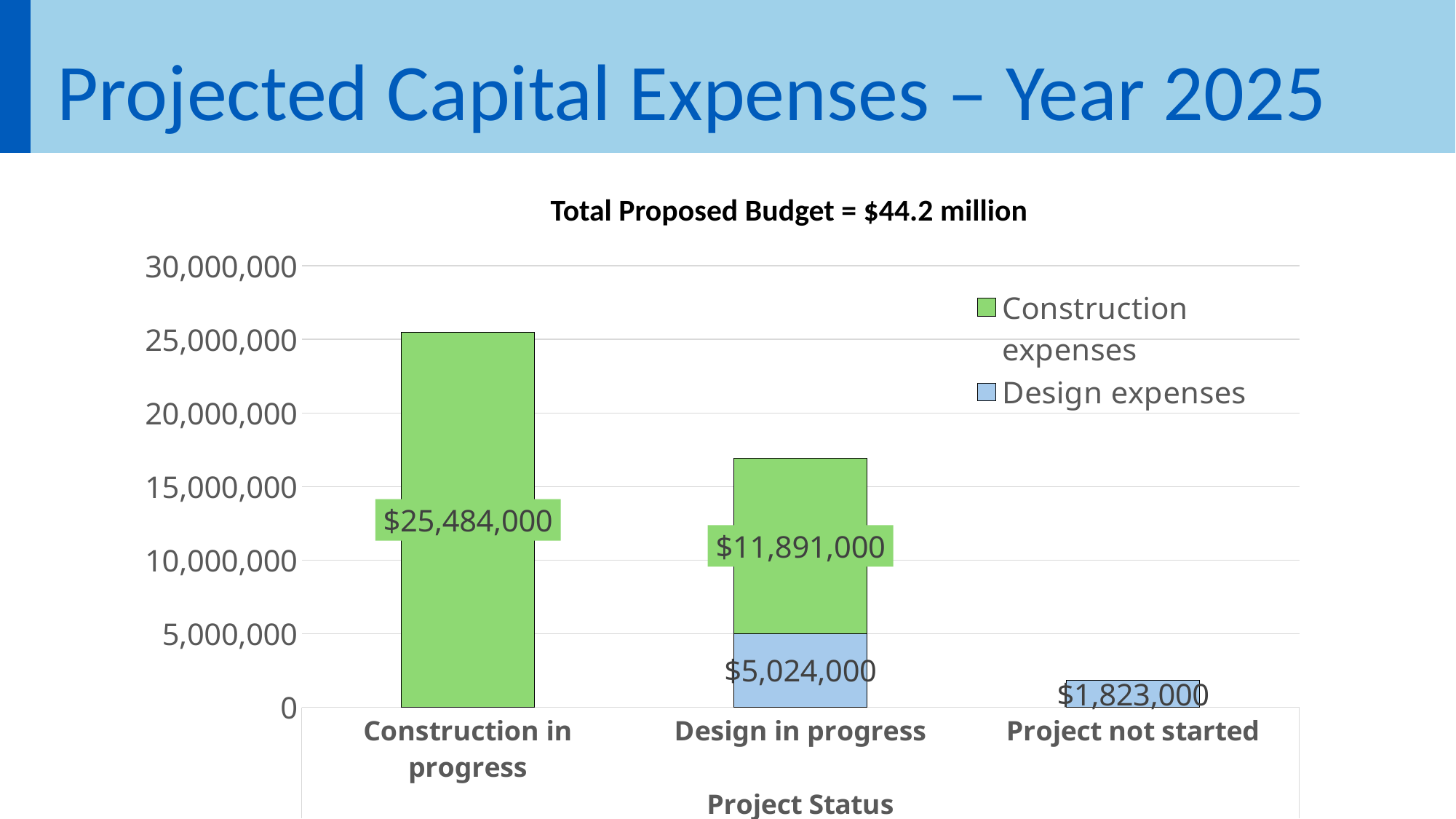
Which is larger: Design expenses for Design in progress or Design expenses for Project not started? Design in progress What is the value of Design expenses for Design in progress? $5,024,000 What kind of chart is shown on the slide? Stacked bar chart How many series does the legend list? 2 How many project status categories are shown on the x axis? 3 Which project status has the lowest total bar? Project not started What is the value of Construction expenses for Design in progress? $11,891,000 What is the value of Construction expenses for Construction in progress? $25,484,000 What is the value of Design expenses for Project not started? $1,823,000 What is the difference between Construction expenses for Construction in progress and for Design in progress? $13,593,000 Which project status has the highest Construction expenses? Construction in progress What is the total of the stacked bar for Design in progress? $16,915,000